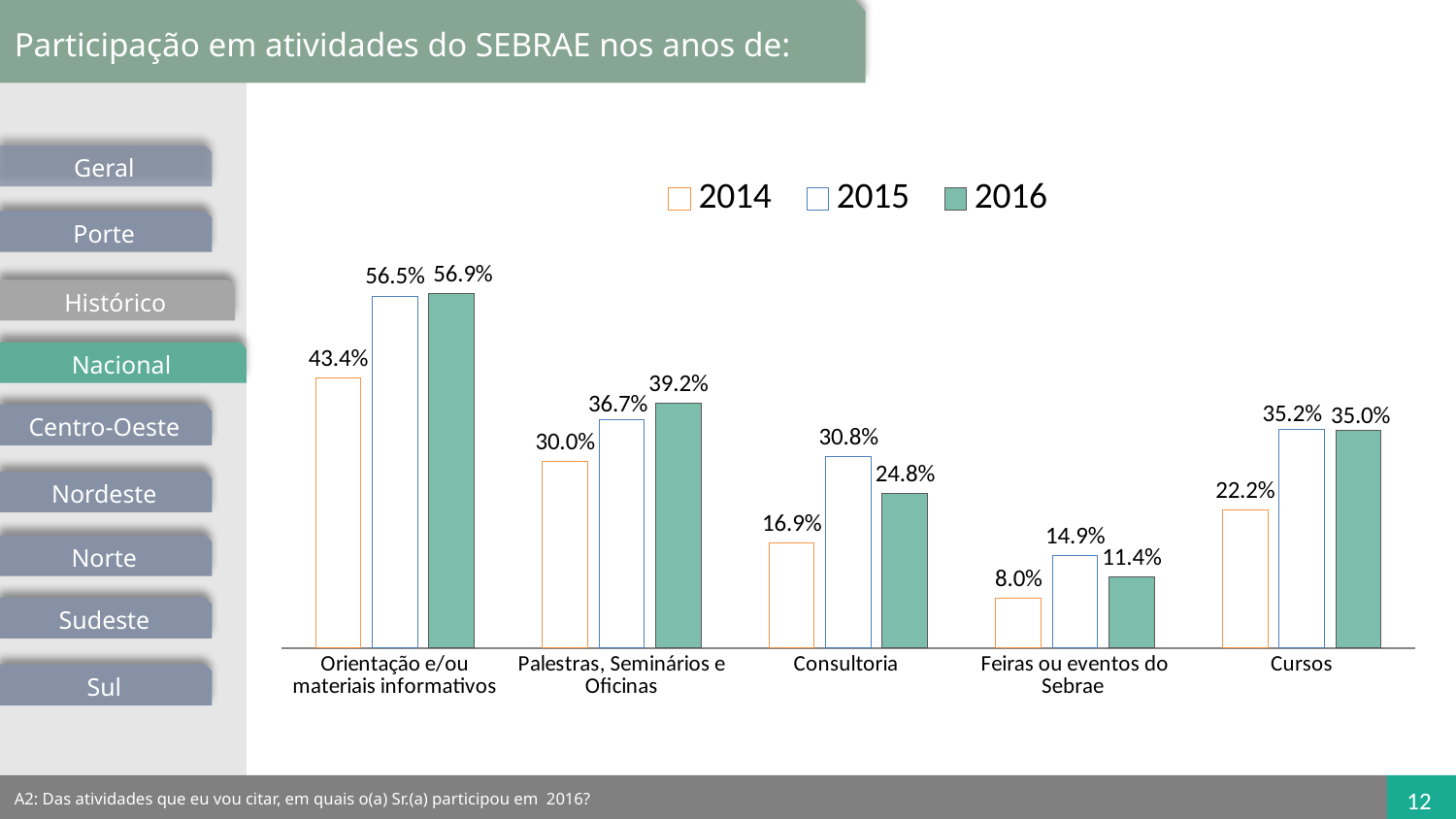
Which category has the lowest 2014 value? Feiras ou eventos do Sebrae What is the 2015 value for Feiras ou eventos do Sebrae? 14.9% Which is larger for Palestras, Seminários e Oficinas: the 2015 value or the 2016 value? 2016 What is the difference between the 2015 and 2014 values for Consultoria? 13.9% What is the 2014 value for Cursos? 22.2% Which category has the highest 2016 value? Orientação e/ou materiais informativos How many categories are shown on the x axis? 5 How many series does the legend list? 3 Did the value for Cursos rise or fall from 2015 to 2016? Fall What kind of chart is shown on the slide? Bar chart Which series is shown with filled green bars in the legend? 2016 What is the 2016 value for Consultoria? 24.8%